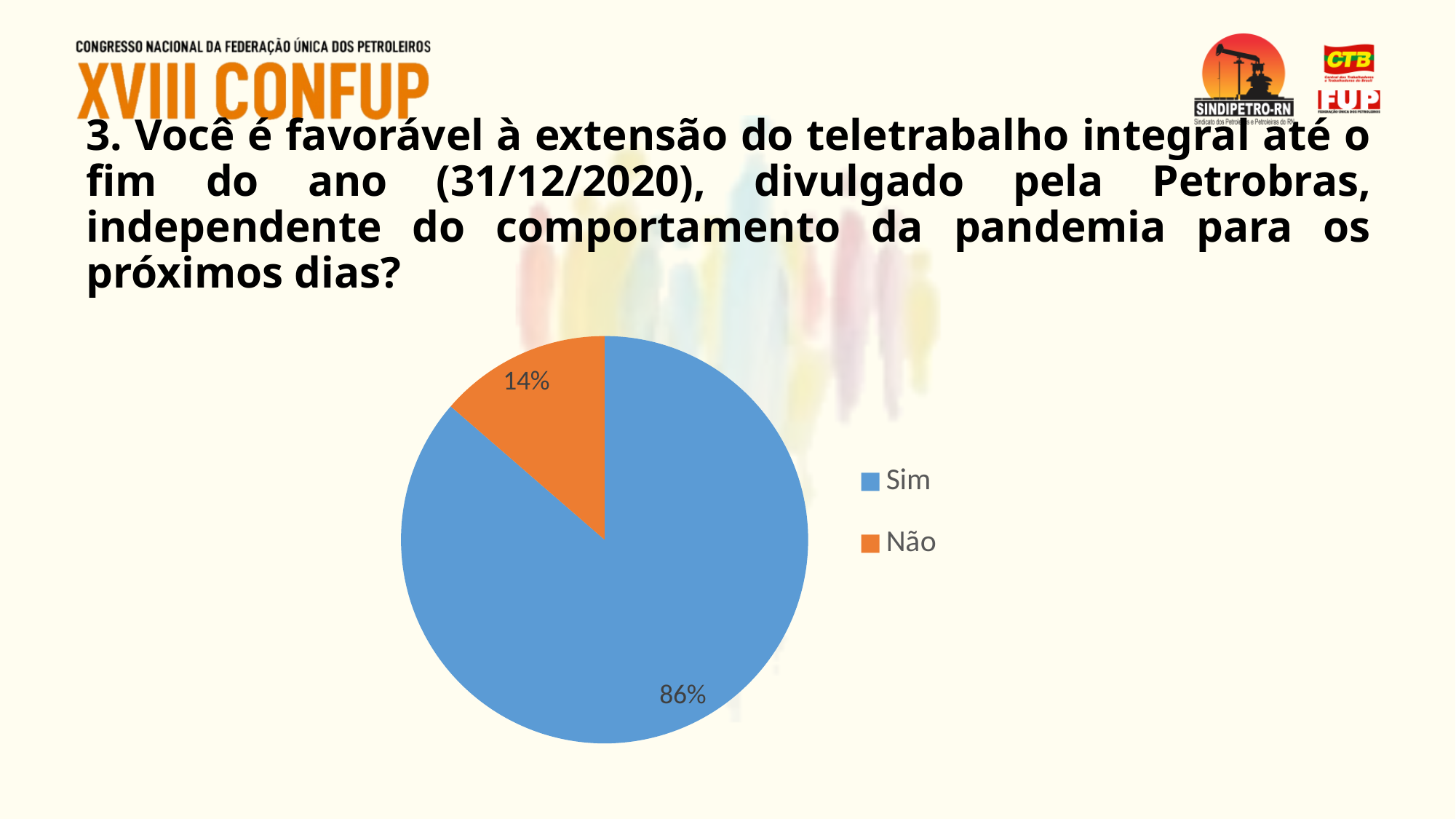
How many entries does the legend list? 2 How many slices does the pie chart have? 2 What kind of chart is shown on the slide? pie chart What percentage of the pie is labelled "Sim"? 86% What colour is the "Sim" slice? blue Which is larger, the "Sim" slice or the "Não" slice? Sim What colour is the "Não" slice? orange Which slice of the pie is the largest? Sim What is the difference in percentage points between the "Sim" and "Não" slices? 72 Which slice of the pie is the smallest? Não What share of the pie does the "Não" slice represent? 14% What percentage of the pie is labelled "Não"? 14%